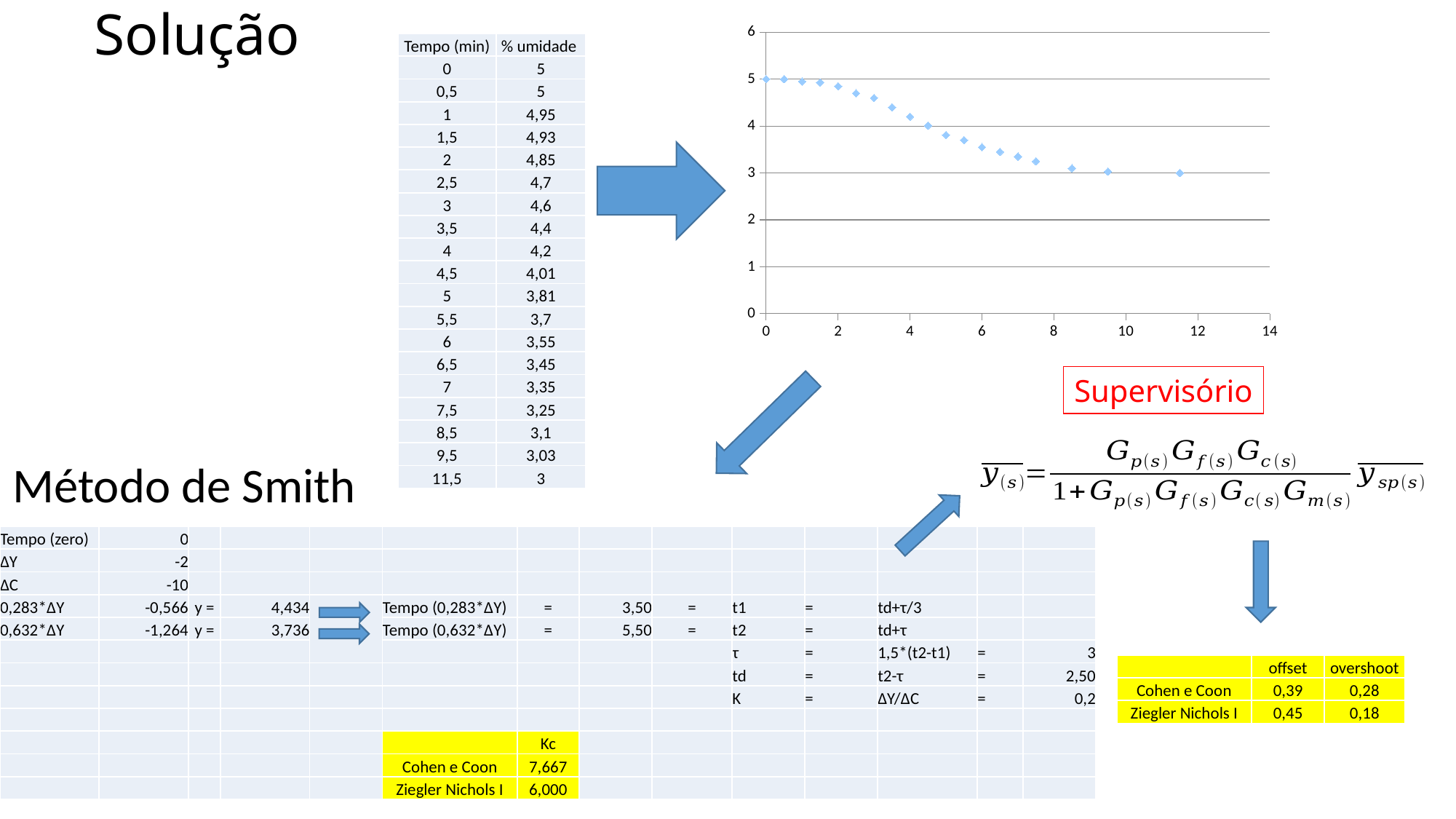
At which x value is the lowest plotted point? 11,5 Is the plotted value at x = 6 greater or less than 4? less Is the plotted value at x = 7 greater or less than 3? greater Do the plotted values rise or fall as the x axis increases? fall What is the plotted value at x = 0? 5 What is the difference between the first plotted value (at x = 0) and the last plotted value (at x = 11,5)? 2 Which plotted value is larger, the one at x = 1 or the one at x = 7? x = 1 Is the plotted value at x = 4 greater or less than 4? greater What is the plotted value at x = 11,5, the last point? 3 What kind of chart is shown at the top right of the slide? scatter chart What is the highest value shown on the chart's x axis? 14 What is the highest value shown on the chart's y axis? 6